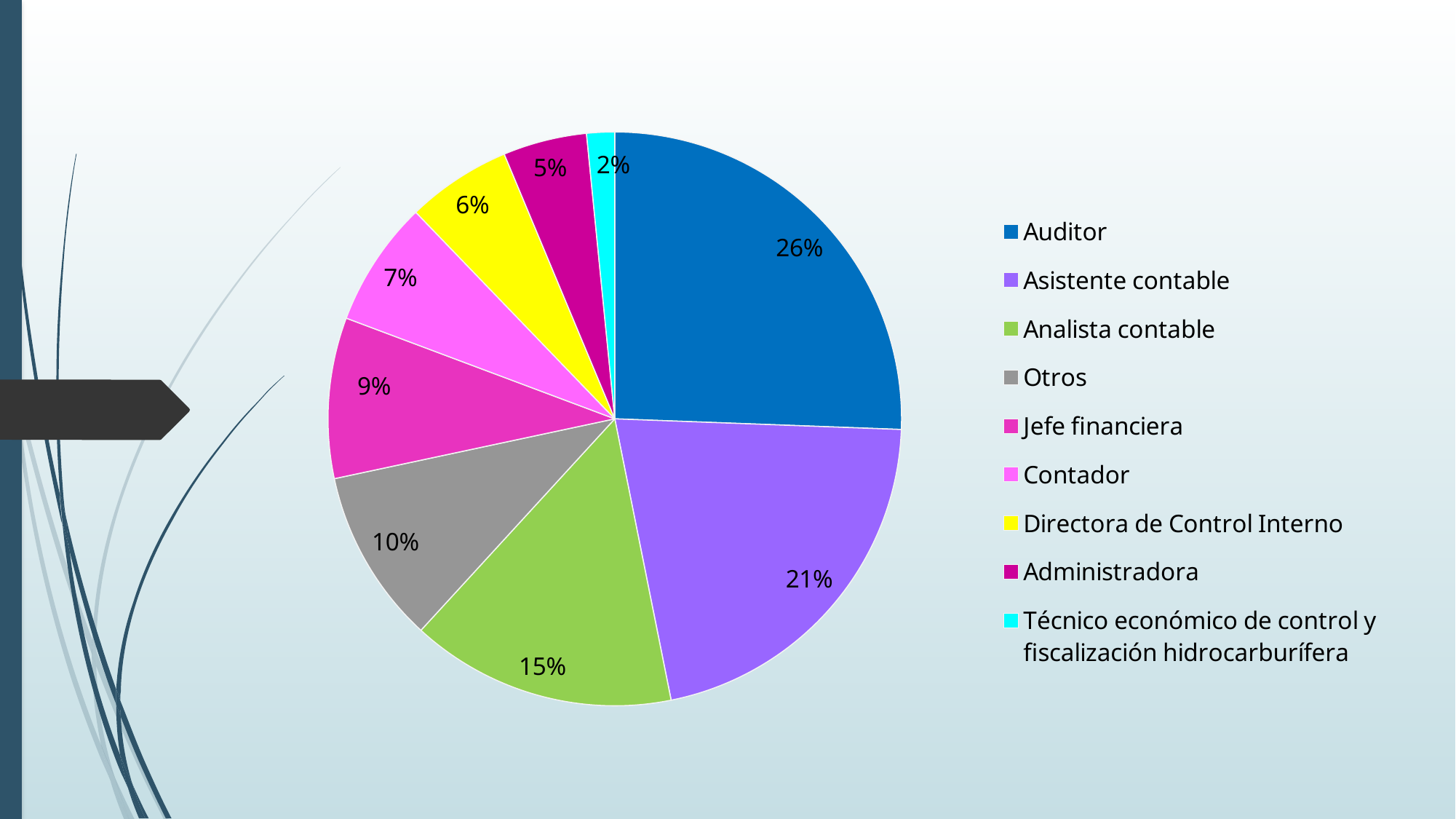
What colour is the Administradora slice? magenta What share of the pie does Analista contable have? 15% What share of the pie does Auditor have? 26% How many categories does the pie chart have? 9 What share of the pie does Otros have? 10% What is the difference between the shares of Auditor and Asistente contable? 5% Which category has the largest slice of the pie? Auditor What kind of chart is shown on the slide? pie chart Which has a larger share, Jefe financiera or Contador? Jefe financiera Which category has the smallest slice of the pie? Técnico económico de control y fiscalización hidrocarburífera